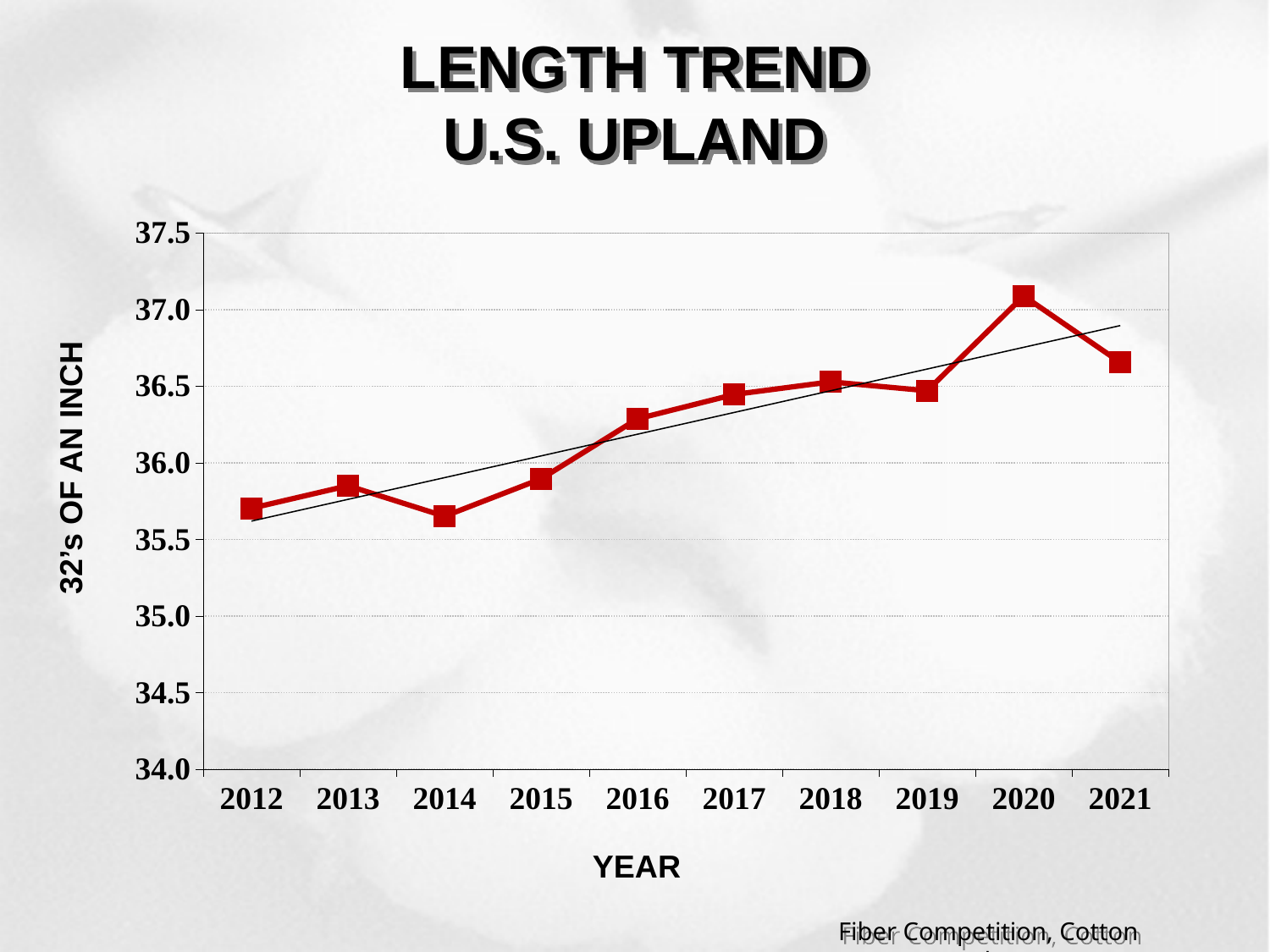
Which year has the larger value, 2012 or 2021? 2021 Is the value for 2021 greater or less than 36.5? greater How many years are plotted on the x axis? 10 Is the value for 2020 greater or less than 37.0? greater Which year has the highest length value? 2020 What kind of chart is shown on the slide? line chart Is the value for 2016 greater or less than 36.0? greater What is the label on the vertical axis? 32's OF AN INCH Which year has the larger value, 2020 or 2021? 2020 Do the values generally rise or fall from 2012 to 2021? rise Which year has the lowest length value? 2014